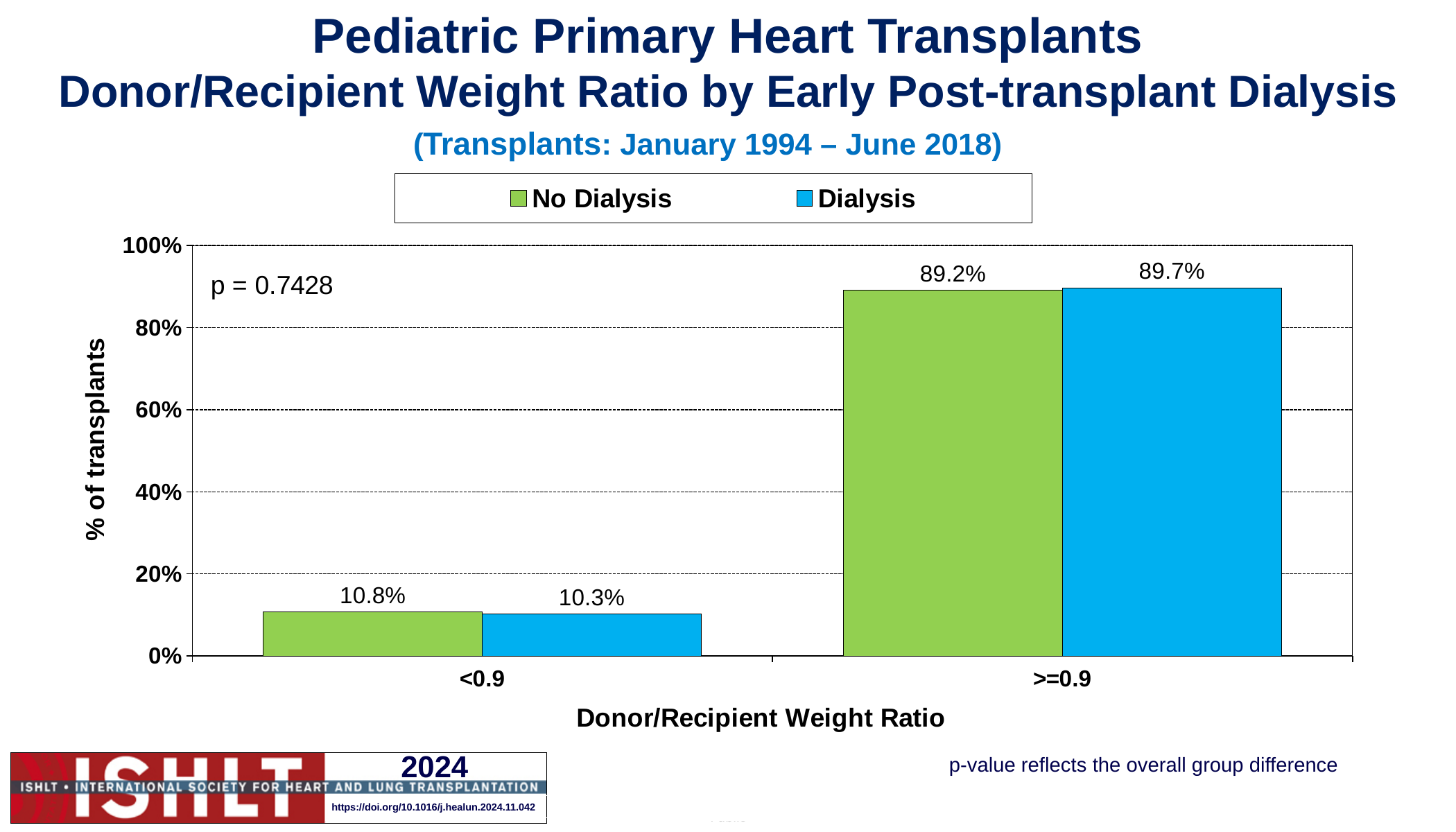
How many donor/recipient weight ratio categories are shown on the x axis? 2 What percentage of transplants with Dialysis had a donor/recipient weight ratio >=0.9? 89.7% Which weight ratio category has the lowest percentage of transplants for the Dialysis group? <0.9 Is the Dialysis value for the >=0.9 category greater or less than 80%? greater What is the difference between the No Dialysis and Dialysis values in the <0.9 category? 0.5% What kind of chart is shown on the slide? Bar chart Which weight ratio category has the highest percentage of transplants for the No Dialysis group? >=0.9 What p-value is shown on the chart? p = 0.7428 What percentage of transplants with No Dialysis had a donor/recipient weight ratio <0.9? 10.8% What is the value for the Dialysis group in the <0.9 weight ratio category? 10.3% What is the value for the No Dialysis group in the >=0.9 weight ratio category? 89.2% How many series does the legend list? 2